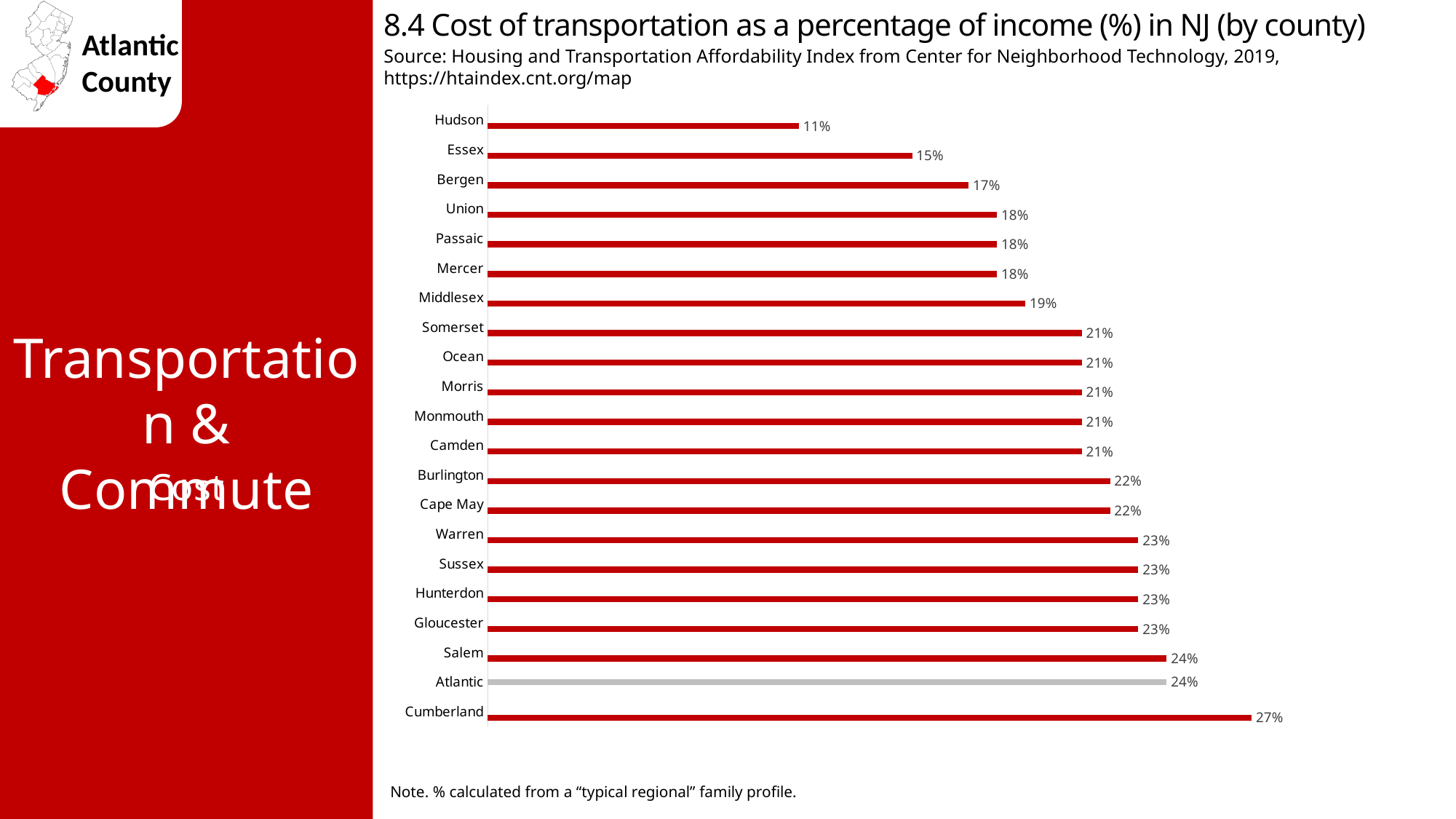
Which county has the highest cost of transportation as a percentage of income? Cumberland Which has a higher value, Cumberland or Warren? Cumberland Which has a higher value, Bergen or Salem? Salem What is the value shown for Middlesex County? 19% What is the cost of transportation as a percentage of income for Atlantic County? 24% Which county has the lowest cost of transportation as a percentage of income? Hudson What is the cost of transportation as a percentage of income for Hudson County? 11% What is the difference between the values for Atlantic and Essex? 9% Which county's bar is shown in a different colour (grey) from the others? Atlantic What type of chart is shown on the slide? Bar chart What is the difference between the values for Cumberland and Hudson? 16% How many counties are shown in the chart? 21